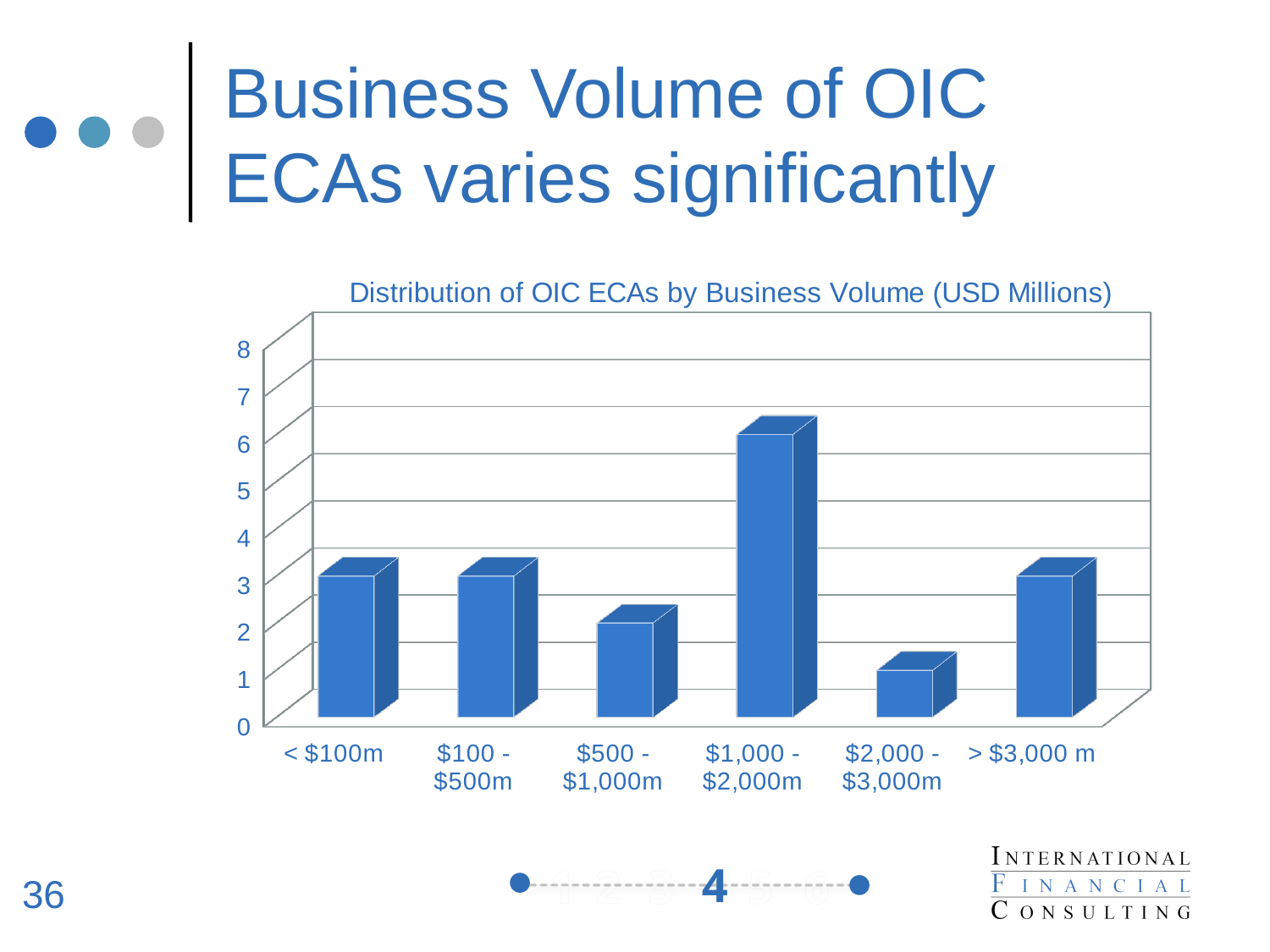
How many OIC ECAs fall in the $500 - $1,000m category? 2 How many OIC ECAs fall in the $2,000 - $3,000m category? 1 How many business volume categories are shown on the x axis? 6 Is the value for $1,000 - $2,000m greater or less than 5? greater Which is larger, the value for $500 - $1,000m or the value for > $3,000 m? > $3,000 m How many OIC ECAs fall in the $1,000 - $2,000m category? 6 Is the value for $2,000 - $3,000m greater or less than 2? less What kind of chart is shown on the slide? bar chart Which business volume category has the highest number of OIC ECAs? $1,000 - $2,000m How many OIC ECAs fall in the < $100m category? 3 What is the title of the chart? Distribution of OIC ECAs by Business Volume (USD Millions) Which business volume category has the lowest number of OIC ECAs? $2,000 - $3,000m